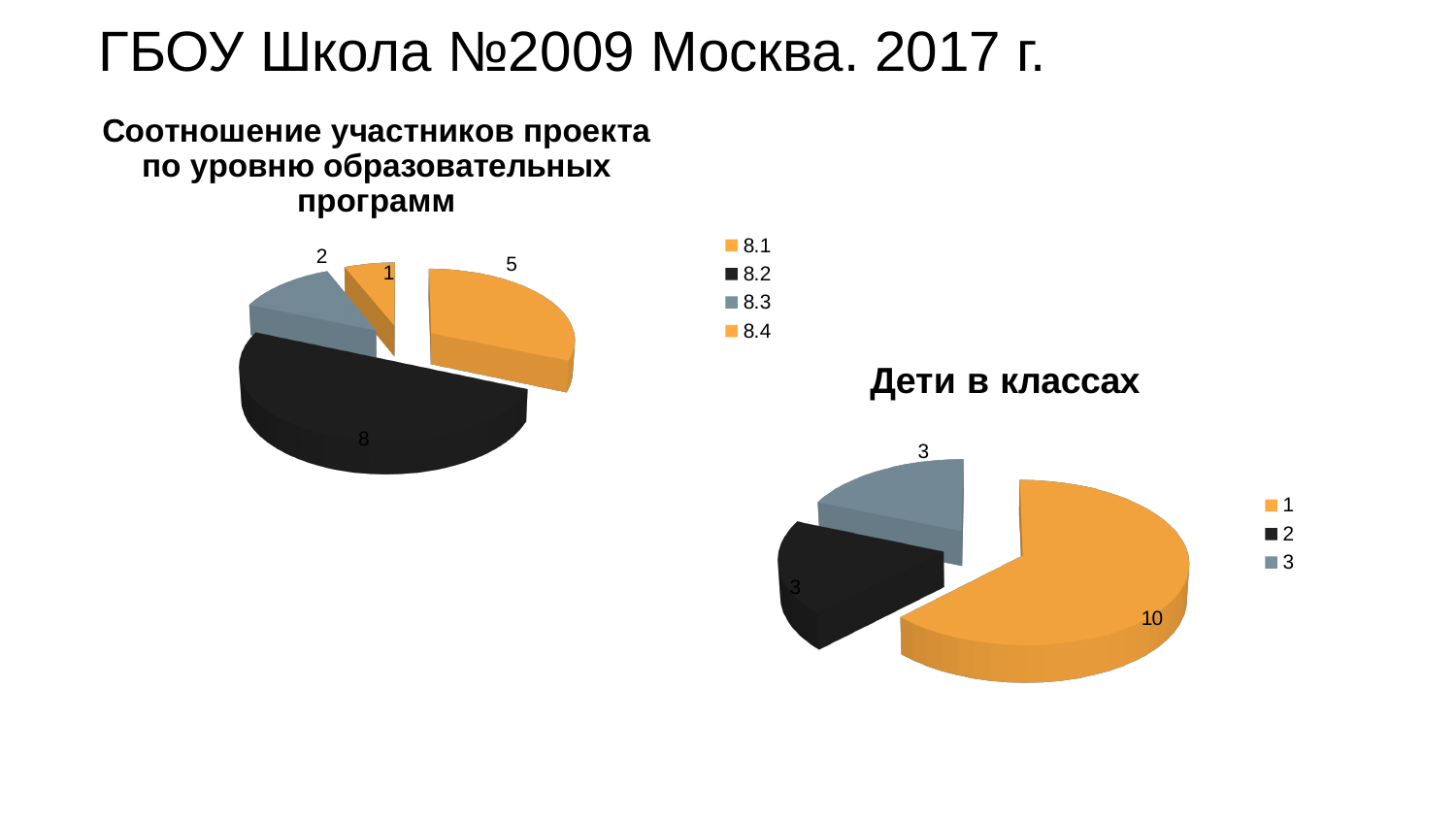
In the chart 'Соотношение участников проекта по уровню образовательных программ', what is the value for 8.2? 8 In the chart 'Соотношение участников проекта по уровню образовательных программ', what is the difference between the values for 8.2 and 8.1? 3 In the chart 'Соотношение участников проекта по уровню образовательных программ', what share of the total does 8.2 represent? 50% In the chart 'Дети в классах', which category has the largest slice? 1 In the chart 'Соотношение участников проекта по уровню образовательных программ', how many categories does the legend list? 4 What type of chart is 'Дети в классах'? Pie chart In the chart 'Дети в классах', how many categories does the legend list? 3 In the chart 'Соотношение участников проекта по уровню образовательных программ', which category has the largest slice? 8.2 In the chart 'Соотношение участников проекта по уровню образовательных программ', which category has the smallest slice? 8.4 In the chart 'Соотношение участников проекта по уровню образовательных программ', what is the value for 8.1? 5 In the chart 'Дети в классах', what is the difference between the values for category 1 and category 2? 7 In the chart 'Дети в классах', what is the value for category 1? 10